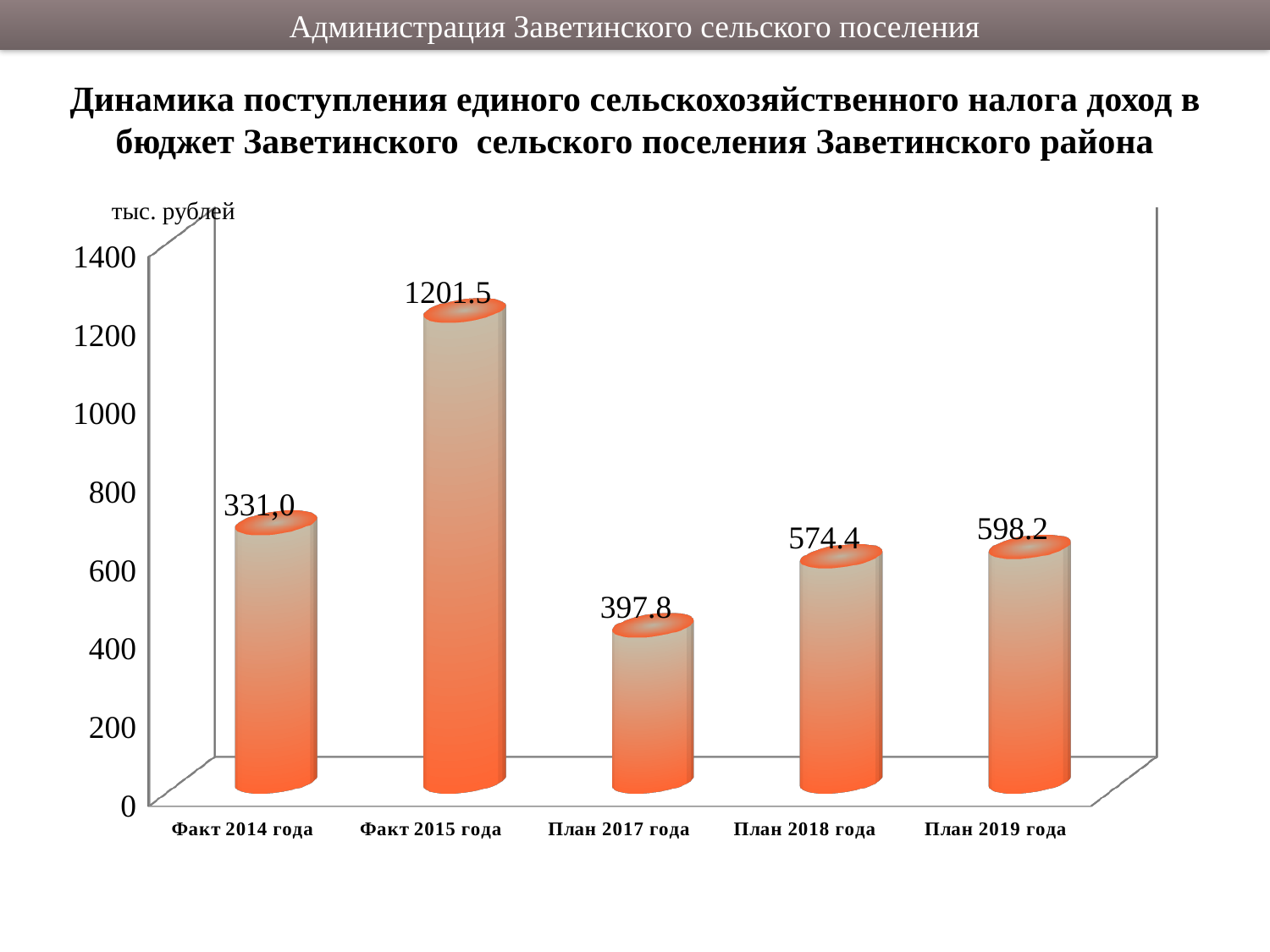
What unit is shown on the chart's value axis? тыс. рублей What is the value for Факт 2014 года? 331,0 What is the value for План 2017 года? 397.8 What is the value for План 2018 года? 574.4 Which category has the highest value? Факт 2015 года What is the difference between the values for Факт 2015 года and План 2017 года? 803.7 What is the value for Факт 2015 года? 1201.5 Is the value for Факт 2015 года greater or less than 1000? greater Which is larger, the value for План 2018 года or План 2017 года? План 2018 года How many categories are shown on the x axis? 5 What is the difference between the values for План 2019 года and План 2018 года? 23.8